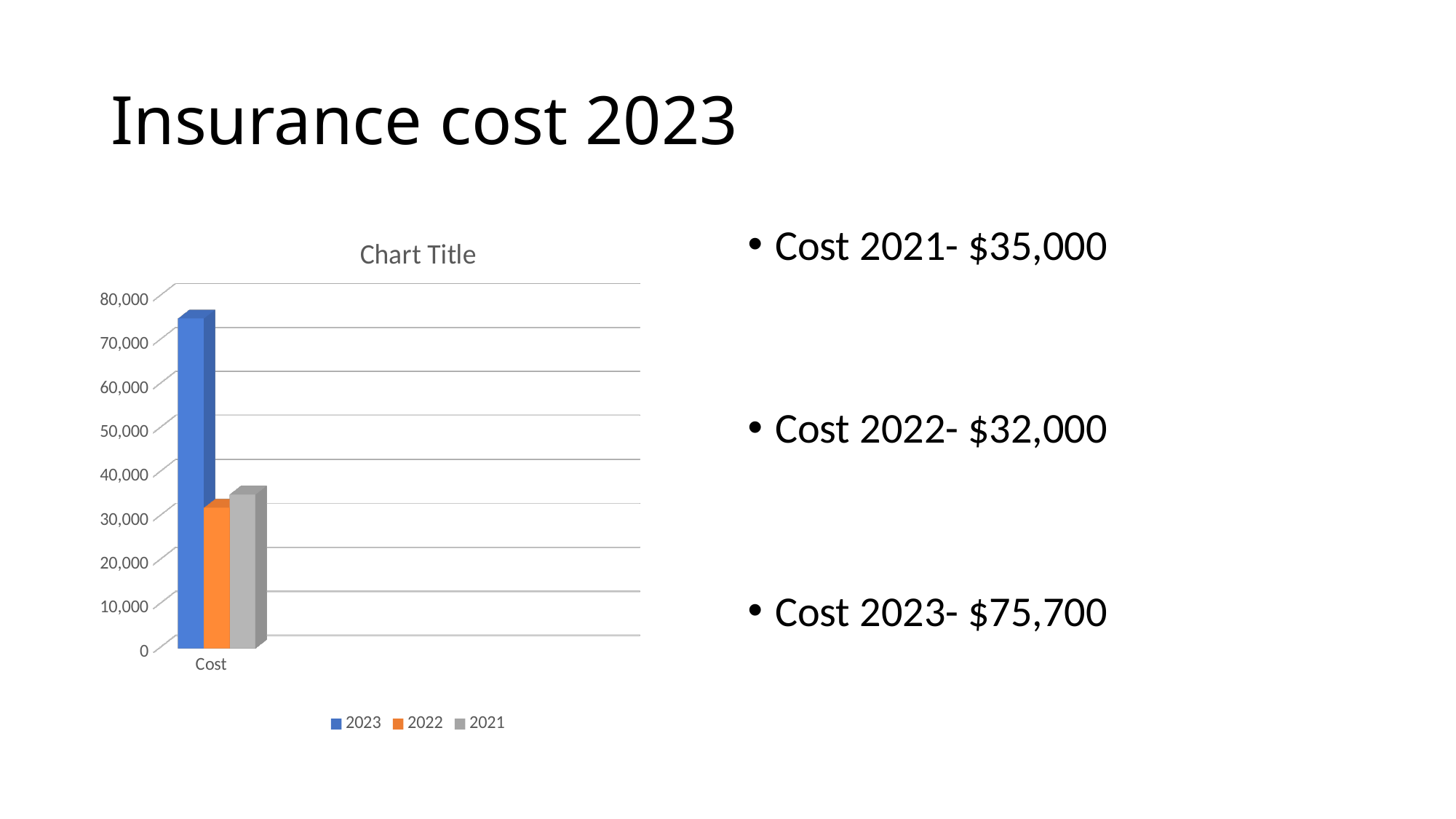
Is the value for 2021 greater or less than 30,000? greater Is the value for 2023 greater or less than 70,000? greater Which series has the shortest bar in the chart? 2022 How many categories are shown on the x axis of the chart? 1 What colour is the bar for the 2022 series? orange Is the value for 2022 greater or less than 40,000? less According to the slide, what is the insurance cost for 2023? $75,700 What is the title shown above the chart? Chart Title How many series does the chart legend list? 3 What kind of chart is shown on the slide? bar chart Which bar is taller, 2021 or 2022? 2021 Which series has the tallest bar in the chart? 2023